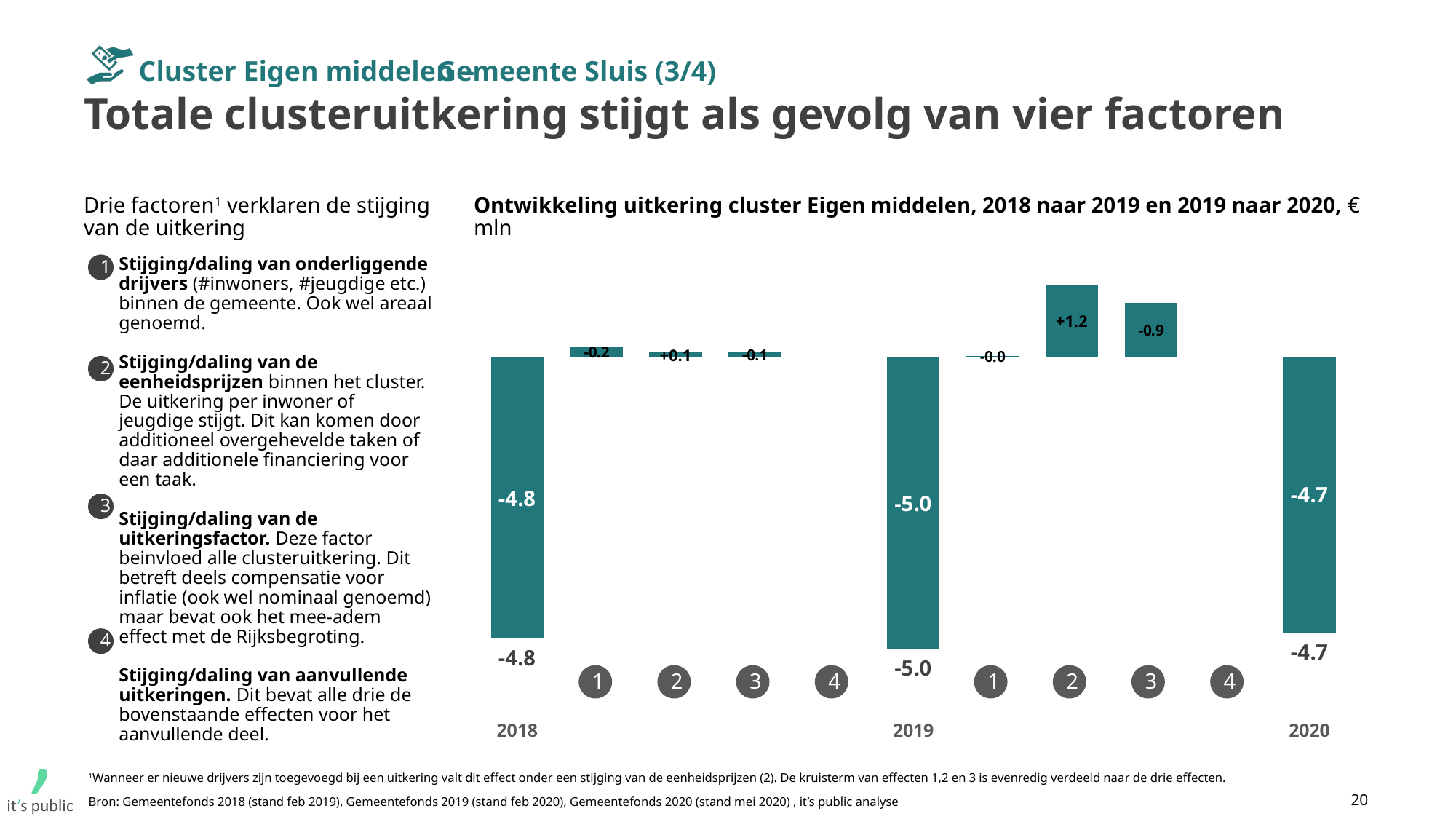
What is the value shown for 2020 in the chart? -4.7 What is the value of factor 2 between 2019 and 2020? +1.2 Which factor between 2019 and 2020 has the largest positive effect? Factor 2 (+1.2) What is the value of factor 1 between 2018 and 2019? -0.2 What unit is stated in the chart title? € mln What is the value shown for 2019 in the chart? -5.0 Which of the three years (2018, 2019, 2020) has the highest total value? 2020 What is the value shown for 2018 in the chart? -4.8 What is the difference between the 2020 value and the 2019 value? 0.3 What is the value of factor 3 between 2019 and 2020? -0.9 What is the value of factor 2 between 2018 and 2019? +0.1 Which of the three years (2018, 2019, 2020) has the lowest total value? 2019